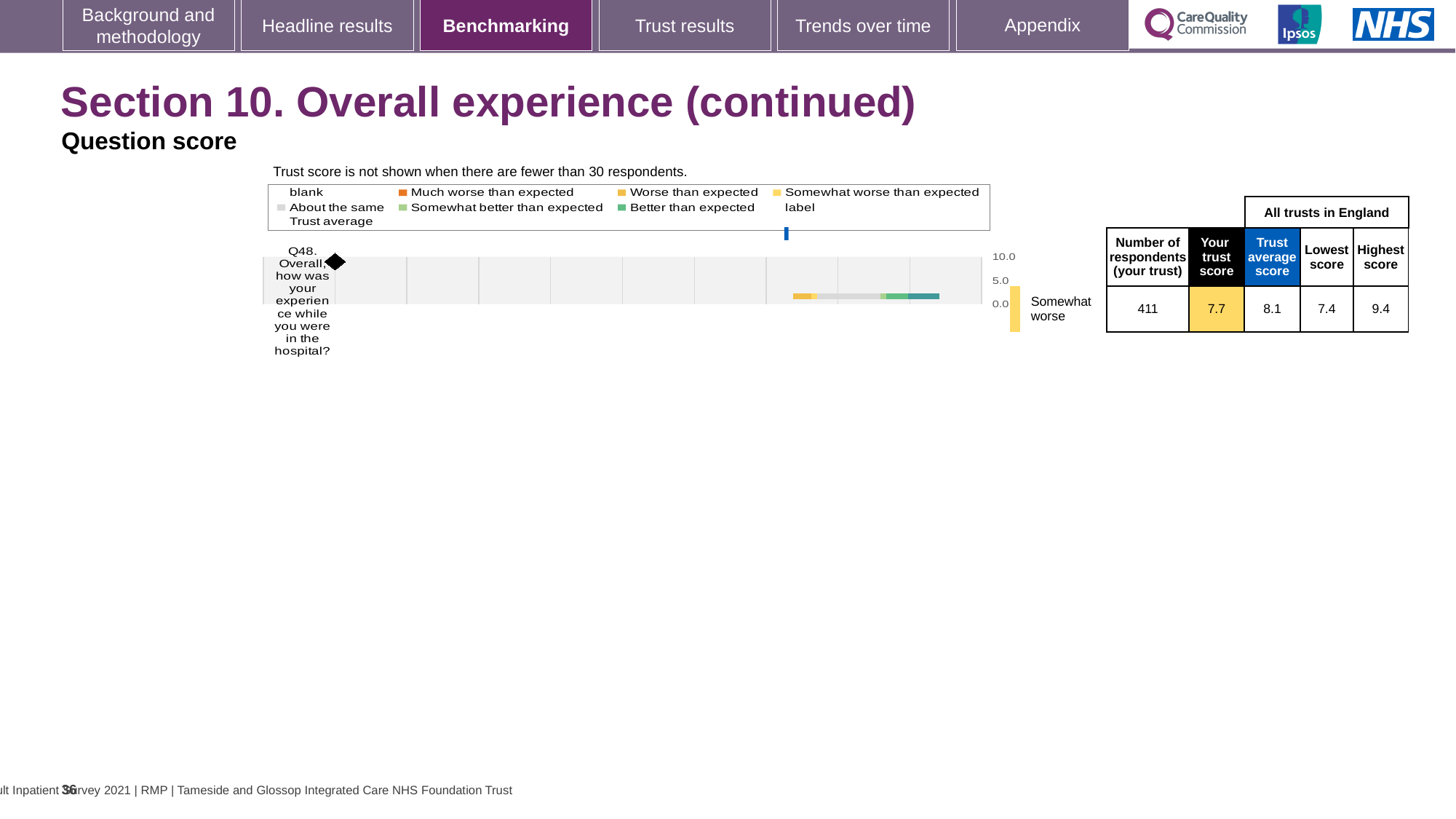
What is the difference between the highest score and the lowest score for Q48? 2.0 What is the 'Your trust score' value for Q48? 7.7 Which is larger for Q48: your trust score or the trust average score? Trust average score What kind of chart is used to show the Q48 benchmarking result? bar chart Which question is plotted in the benchmarking chart? Q48. Overall, how was your experience while you were in the hospital? What is the 'Highest score' for Q48 across all trusts in England? 9.4 What is the number of respondents for Q48 at your trust? 411 Which benchmark category label is shown next to the yellow bar for Q48? Somewhat worse What is the difference between the trust average score and your trust score for Q48? 0.4 What is the 'Trust average score' for Q48 across all trusts in England? 8.1 What is the 'Lowest score' for Q48 across all trusts in England? 7.4 How many questions are plotted in the benchmarking chart? 1